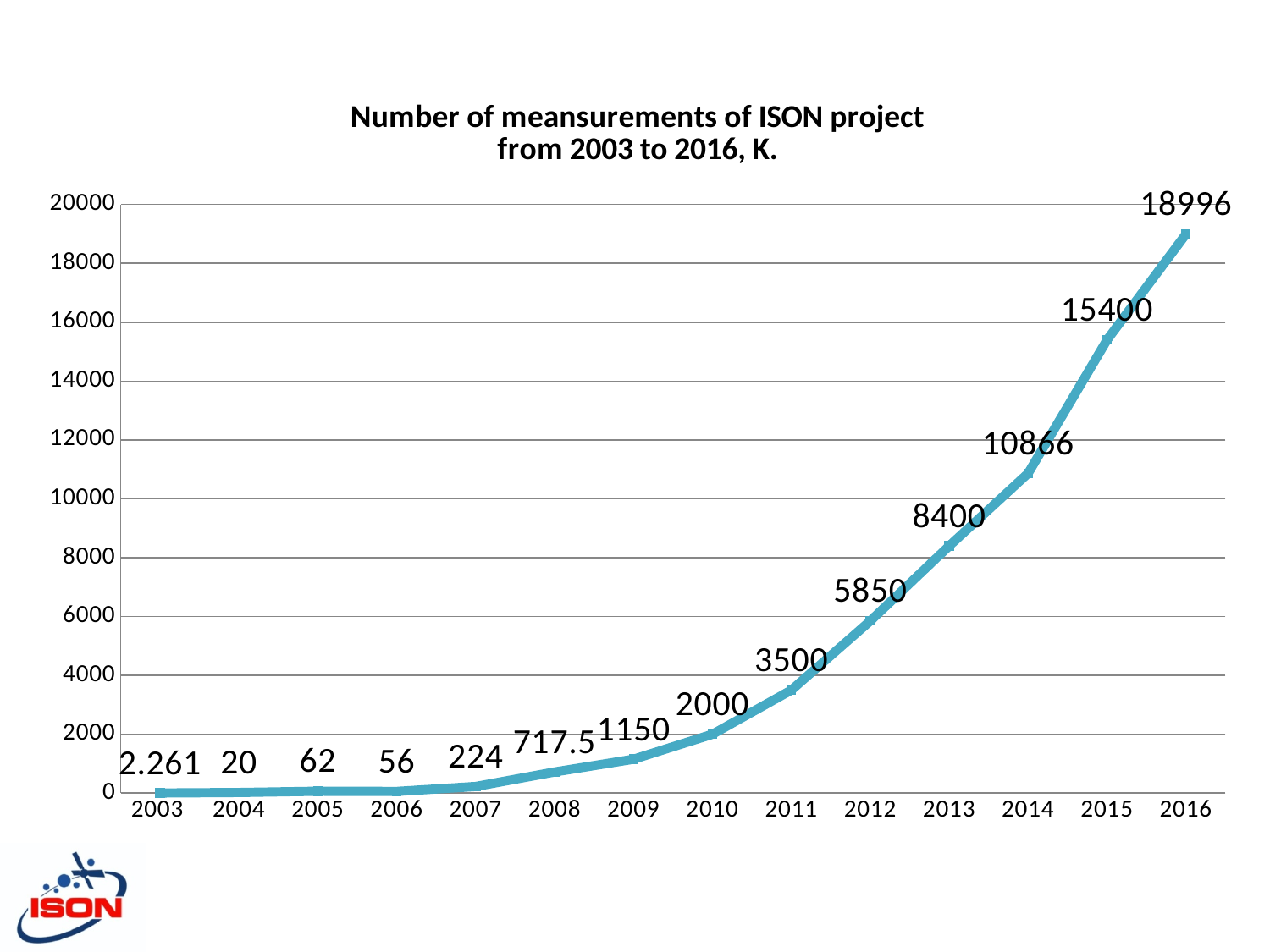
How many years are plotted on the chart? 14 What is the value for 2003? 2.261 What kind of chart is shown on the slide? line chart Which year has the lowest value? 2003 What is the difference between the values for 2016 and 2015? 3596 What is the value for 2008? 717.5 Which year has the highest value? 2016 Which is larger, the value for 2005 or the value for 2006? 2005 What is the value for 2016? 18996 Is the value for 2014 greater or less than 10000? greater What is the difference between the values for 2013 and 2012? 2550 Do the values generally rise or fall from 2007 to 2016? rise